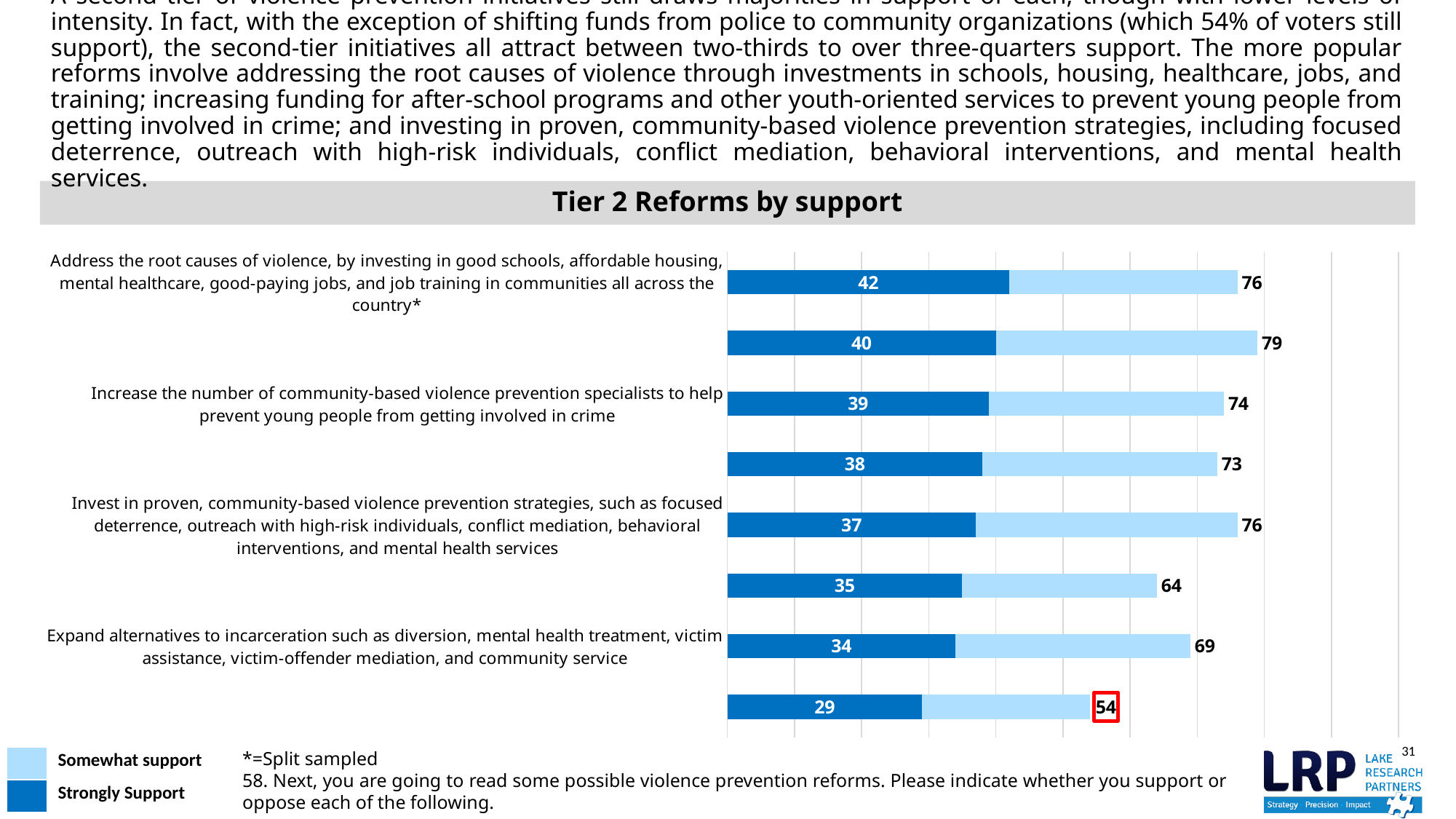
What is the lowest 'Strongly Support' value shown on the chart? 29 What is the 'Strongly Support' value for 'Address the root causes of violence, by investing in good schools, affordable housing, mental healthcare, good-paying jobs, and job training in communities all across the country*'? 42 What is the total support shown for 'Expand alternatives to incarceration such as diversion, mental health treatment, victim assistance, victim-offender mediation, and community service'? 69 How many series does the legend list for the 'Tier 2 Reforms by support' chart? 2 How much higher is the 'Strongly Support' value for 'Address the root causes of violence...' than for 'Expand alternatives to incarceration...'? 8 What type of chart is shown under the title 'Tier 2 Reforms by support'? Stacked bar chart What is the highest total support value shown on the chart? 79 How many bars are plotted in the 'Tier 2 Reforms by support' chart? 8 Which series does the dark blue colour represent in the legend? Strongly Support Which has the larger total support: 'Invest in proven, community-based violence prevention strategies...' or 'Increase the number of community-based violence prevention specialists...'? Invest in proven, community-based violence prevention strategies What is the 'Strongly Support' value for 'Increase the number of community-based violence prevention specialists to help prevent young people from getting involved in crime'? 39 What is the 'Somewhat support' value for 'Address the root causes of violence...', given its total of 76 and 'Strongly Support' of 42? 34